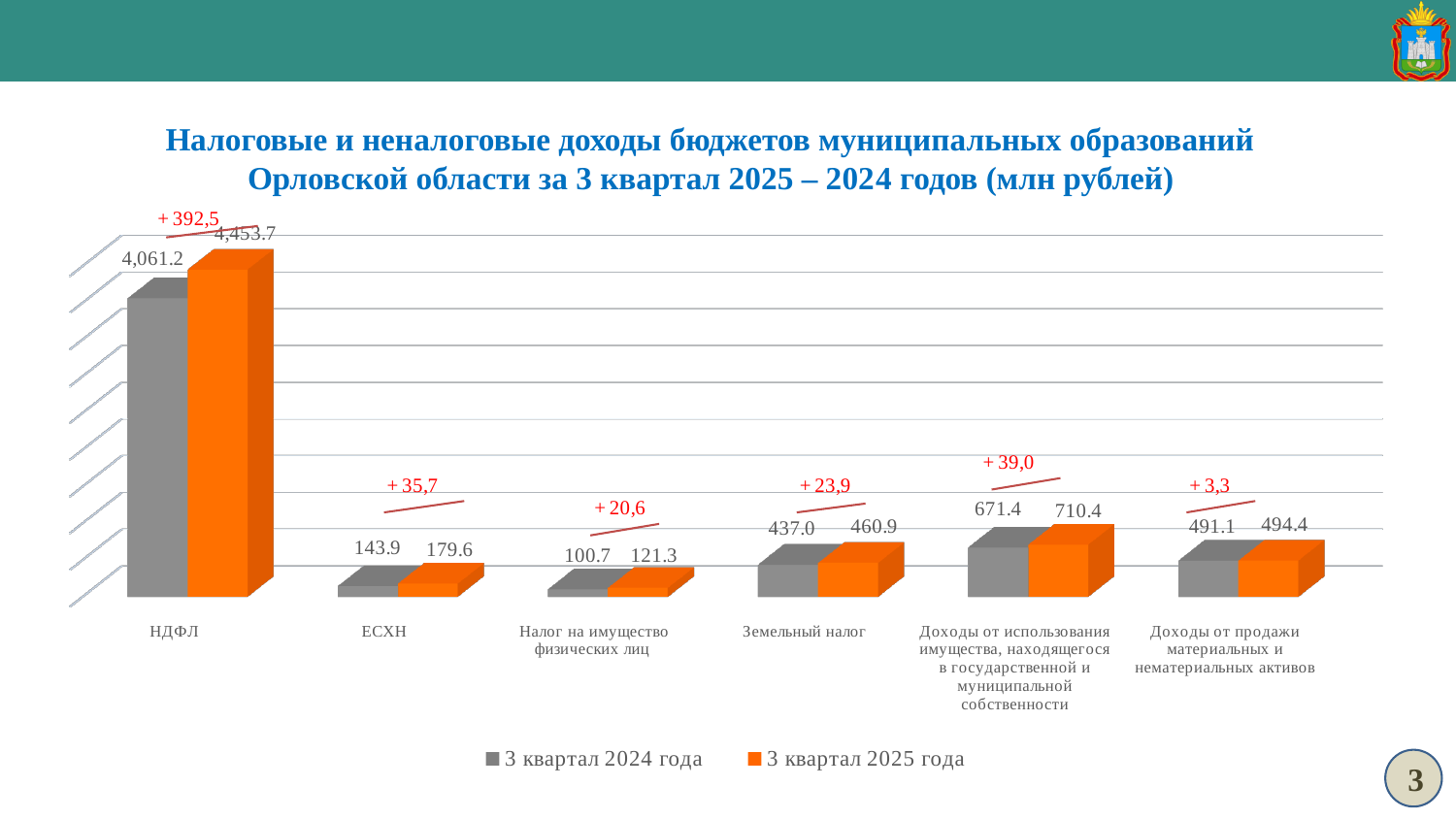
What is the value for Налог на имущество физических лиц in the 3 квартал 2024 года series? 100.7 What kind of chart is shown on the slide? Bar chart What colour represents the 3 квартал 2025 года series in the chart? Orange Which category has the lowest value in the 3 квартал 2024 года series? Налог на имущество физических лиц Which is larger for Земельный налог: the 3 квартал 2024 года value or the 3 квартал 2025 года value? 3 квартал 2025 года What is the difference between the 3 квартал 2025 года and 3 квартал 2024 года values for Доходы от использования имущества, находящегося в государственной и муниципальной собственности? 39.0 What is the value for ЕСХН in the 3 квартал 2025 года series? 179.6 What is the value for НДФЛ in the 3 квартал 2025 года series? 4,453.7 What is the value for Земельный налог in the 3 квартал 2024 года series? 437.0 How many series does the legend list? 2 Which category has the highest value in the 3 квартал 2025 года series? НДФЛ How many categories are shown on the x axis of the chart? 6